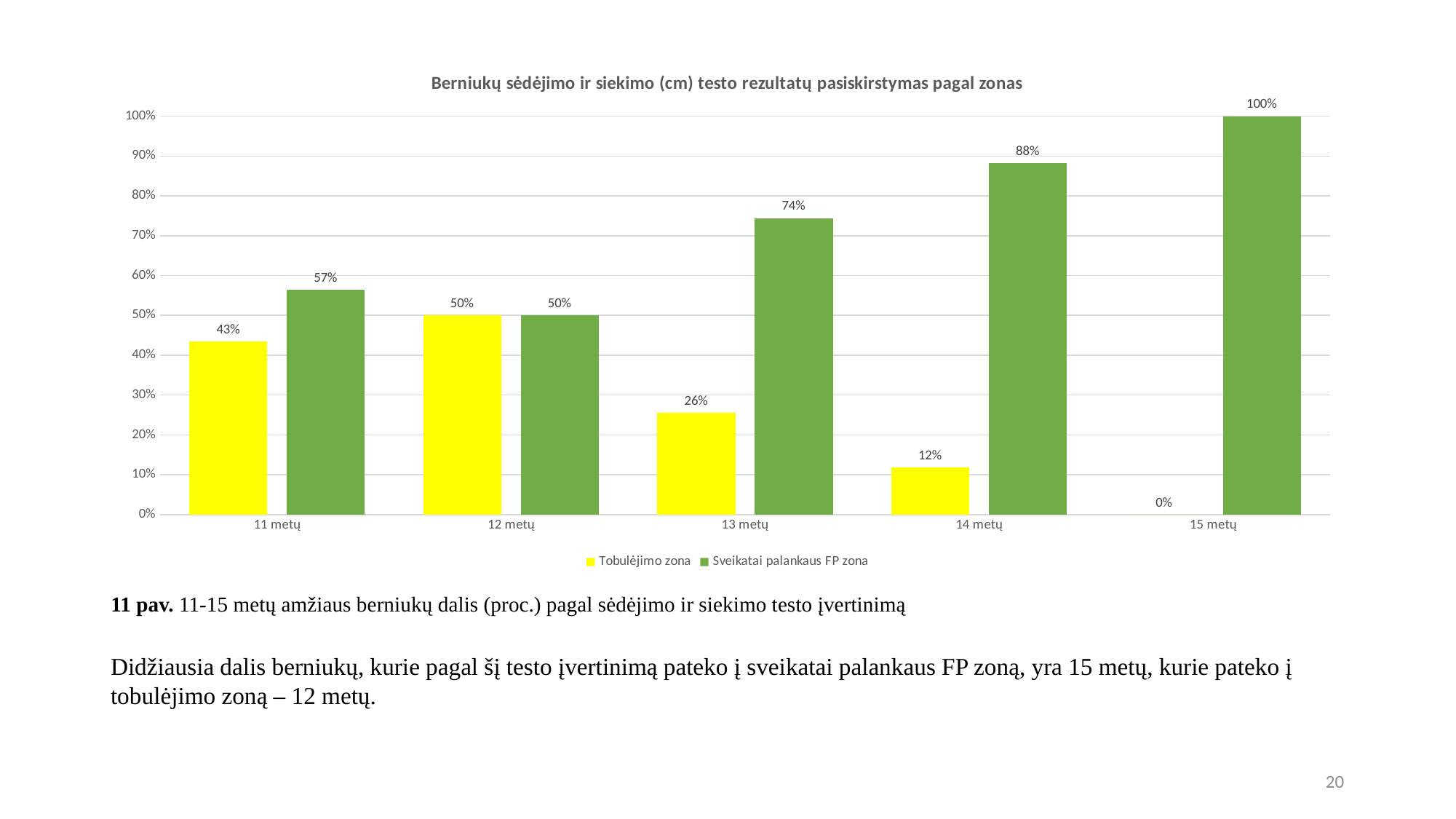
Does the value for Sveikatai palankaus FP zona rise or fall from 11 metų to 15 metų? rise What is the value for Sveikatai palankaus FP zona at 13 metų? 74% Which age group has the highest value for Sveikatai palankaus FP zona? 15 metų What kind of chart is shown? bar chart What is the difference between Sveikatai palankaus FP zona and Tobulėjimo zona at 14 metų? 76% What is the value for Tobulėjimo zona at 11 metų? 43% Is the value for Sveikatai palankaus FP zona at 14 metų greater or less than 80%? greater Which is larger at 11 metų: Tobulėjimo zona or Sveikatai palankaus FP zona? Sveikatai palankaus FP zona Which age group has the lowest value for Tobulėjimo zona? 15 metų How many series does the legend list? 2 What is the value for Tobulėjimo zona at 15 metų? 0% How many age groups are shown on the x axis? 5